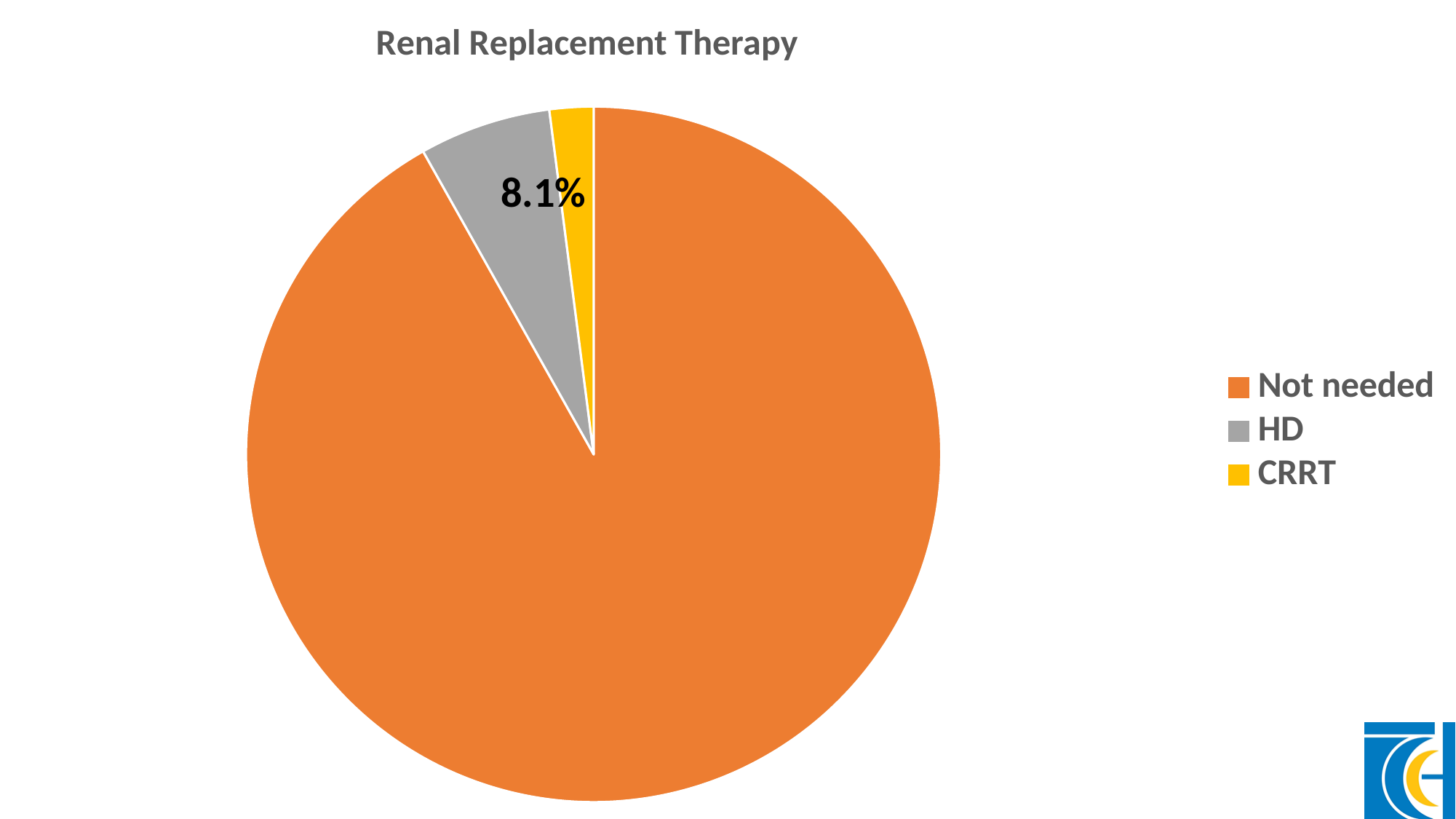
How many entries does the legend list? 3 What kind of chart is shown on the slide? pie chart Which category has the smallest slice of the pie? CRRT What colour is the Not needed slice? orange What percentage is labelled on the HD slice? 8.1% Which slice is larger, Not needed or HD? Not needed Which category has the largest slice of the pie? Not needed What is the title of the chart? Renal Replacement Therapy Which slice is larger, HD or CRRT? HD How many slices does the pie chart have? 3